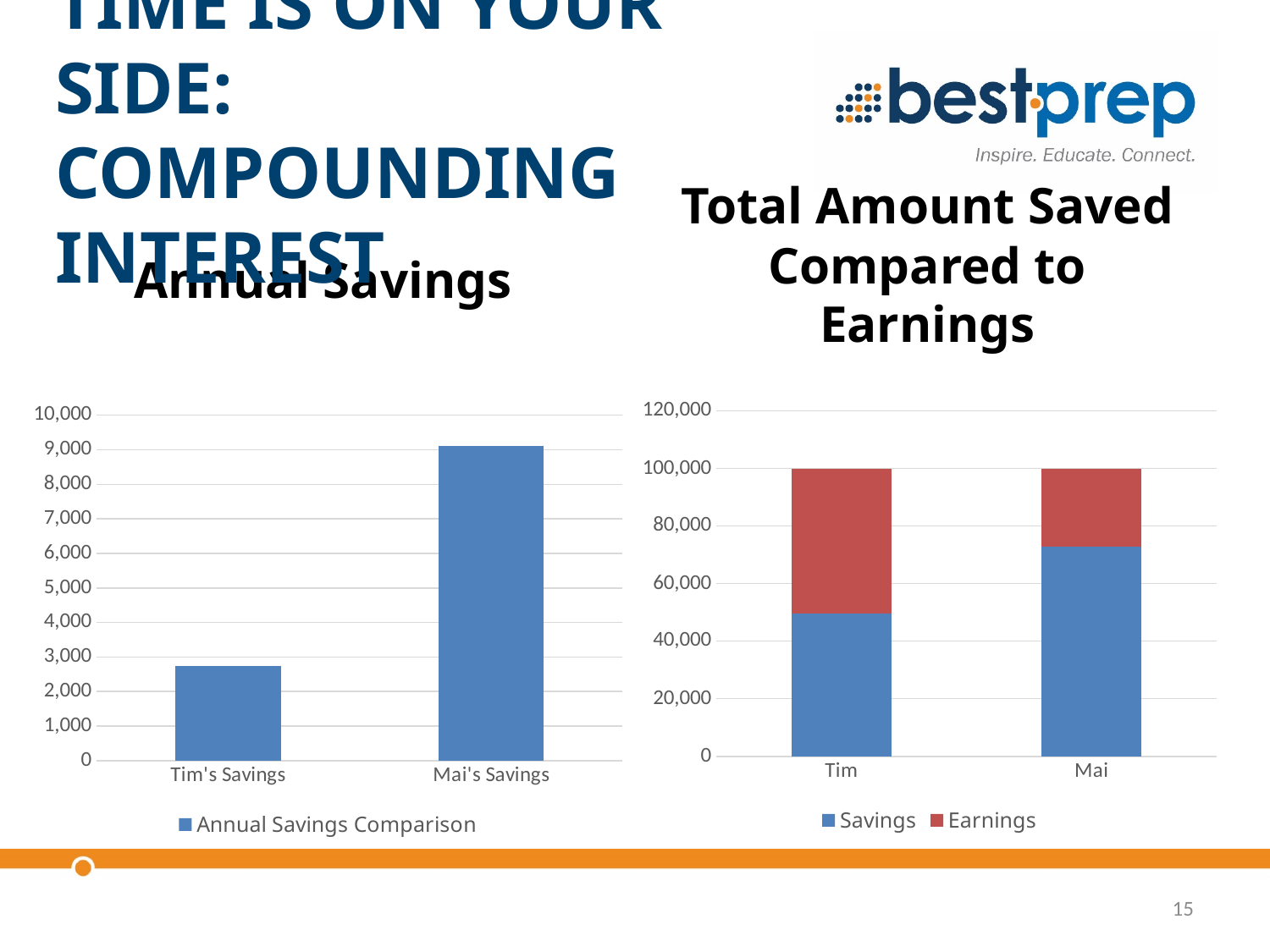
On the Total Amount Saved Compared to Earnings chart, who has the larger Savings value, Tim or Mai? Mai On the Annual Savings chart, how many categories are plotted? 2 On the Total Amount Saved Compared to Earnings chart, is the Savings value for Tim greater or less than 60,000? less On the Annual Savings chart, what is the legend entry? Annual Savings Comparison On the Total Amount Saved Compared to Earnings chart, how many series does the legend list? 2 On the Annual Savings chart, which category has the lowest value? Tim's Savings On the Annual Savings chart, which category has the highest value? Mai's Savings On the Annual Savings chart, is the value for Mai's Savings greater or less than 8,000? greater On the Annual Savings chart, is the value for Tim's Savings greater or less than 3,000? less On the Total Amount Saved Compared to Earnings chart, what colour represents the Earnings series? red On the Annual Savings chart, what kind of chart is shown? bar chart